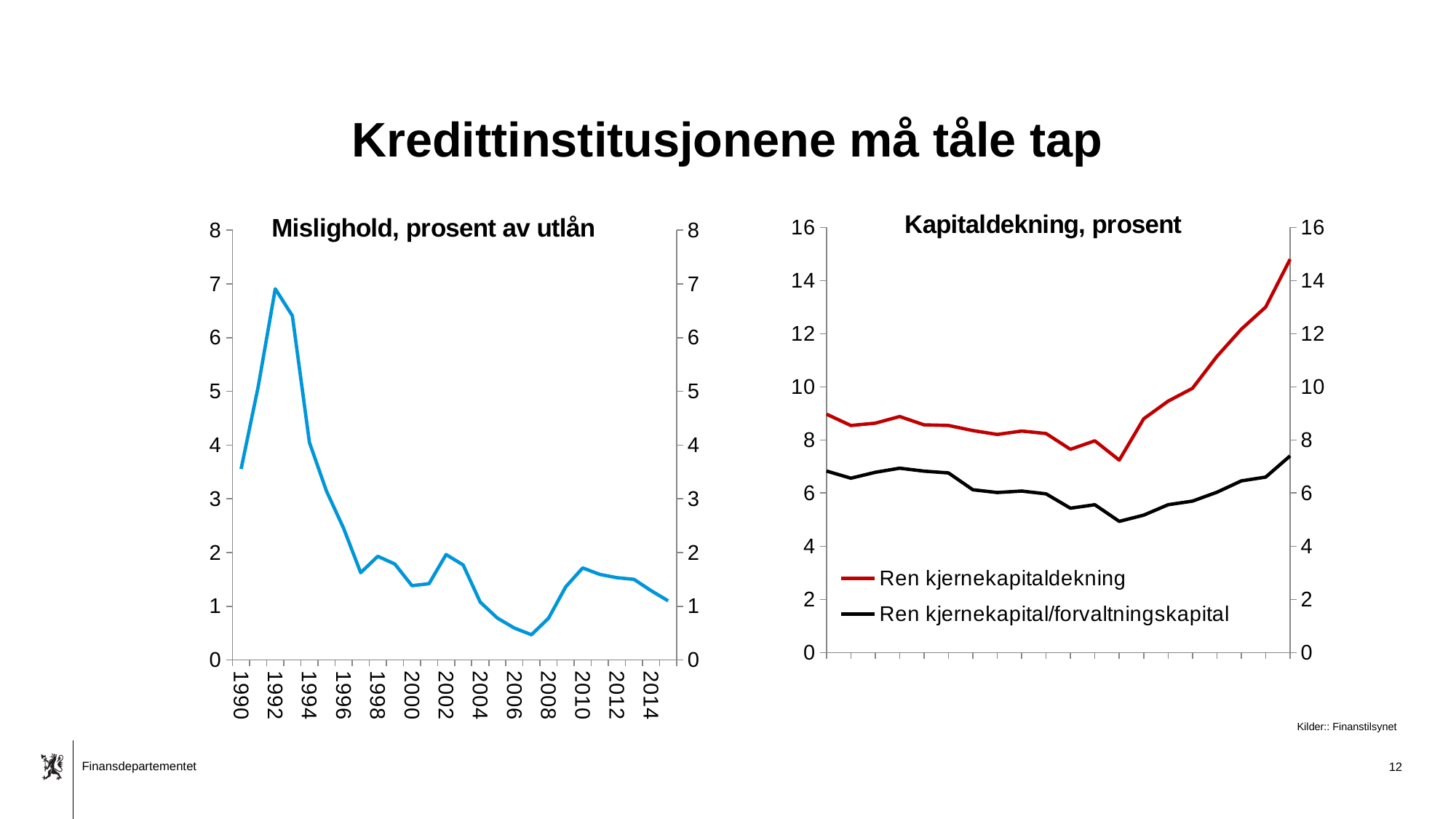
In the left chart 'Mislighold, prosent av utlån', is the value for 1996 greater or less than 3? less What type of chart is the left chart, 'Mislighold, prosent av utlån'? Line chart In the left chart 'Mislighold, prosent av utlån', which is larger, the value for 1992 or the value for 2008? 1992 In the left chart 'Mislighold, prosent av utlån', is the value for 1990 greater or less than 3? greater How many series does the legend of the right chart 'Kapitaldekning, prosent' list? 2 In the left chart 'Mislighold, prosent av utlån', do the values generally rise or fall between 1992 and 1998? Fall In the left chart 'Mislighold, prosent av utlån', is the value for 2006 greater or less than 1? less In the right chart 'Kapitaldekning, prosent', which series has the higher values throughout, 'Ren kjernekapitaldekning' or 'Ren kjernekapital/forvaltningskapital'? Ren kjernekapitaldekning In the right chart 'Kapitaldekning, prosent', what colour is the line for 'Ren kjernekapital/forvaltningskapital'? Black In the left chart 'Mislighold, prosent av utlån', which year has the highest value? 1992